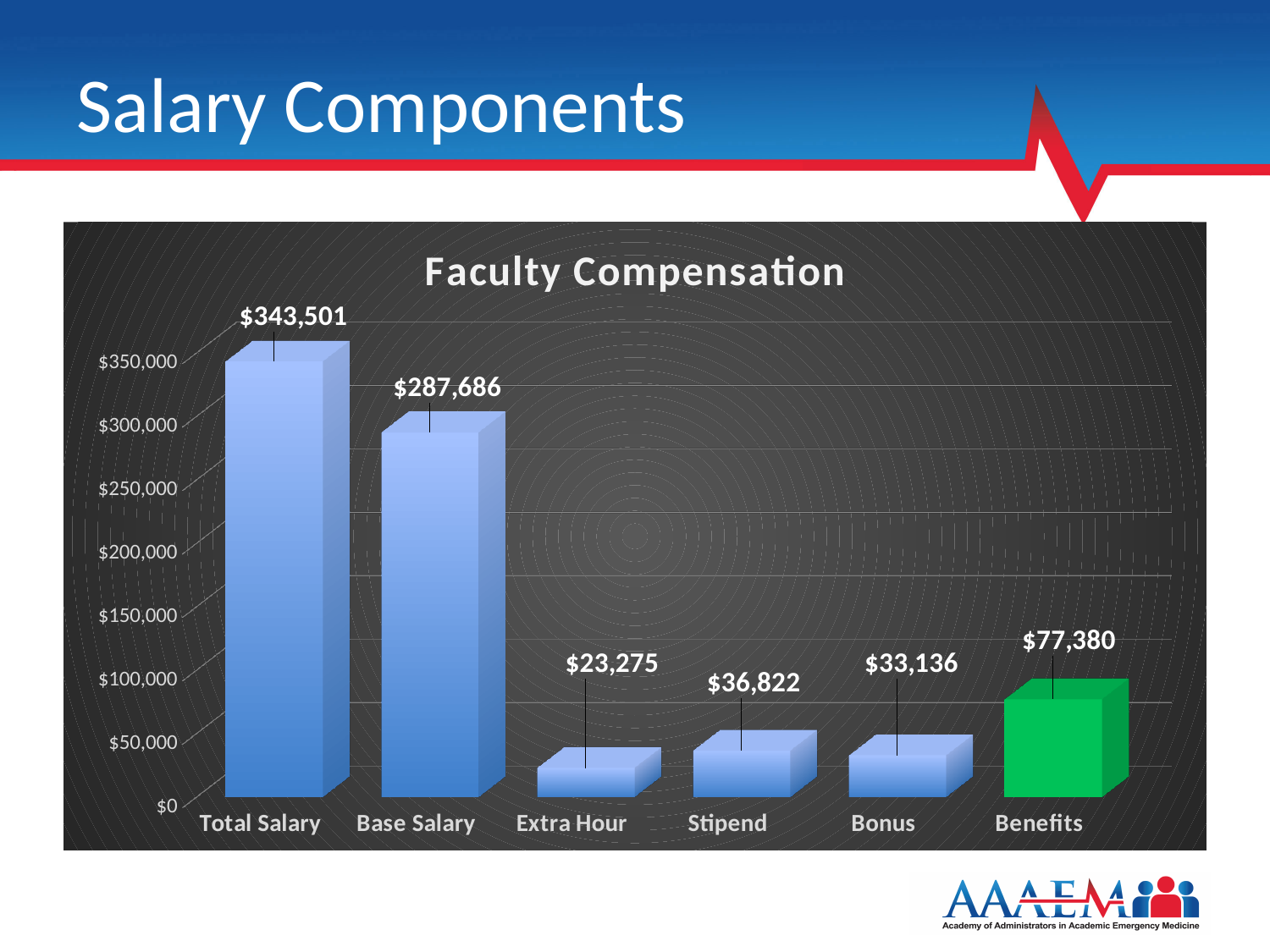
What is the difference between Total Salary and Base Salary? $55,815 What is the value for Stipend? $36,822 Which category has the highest value? Total Salary What is the value for Base Salary? $287,686 Which is larger, Stipend or Bonus? Stipend Is the value for Benefits greater or less than $100,000? less What is the value for Benefits? $77,380 What is the value for Total Salary? $343,501 What kind of chart is this? bar chart How many categories are shown on the x axis? 6 Which category has the lowest value? Extra Hour What is the title of the chart? Faculty Compensation